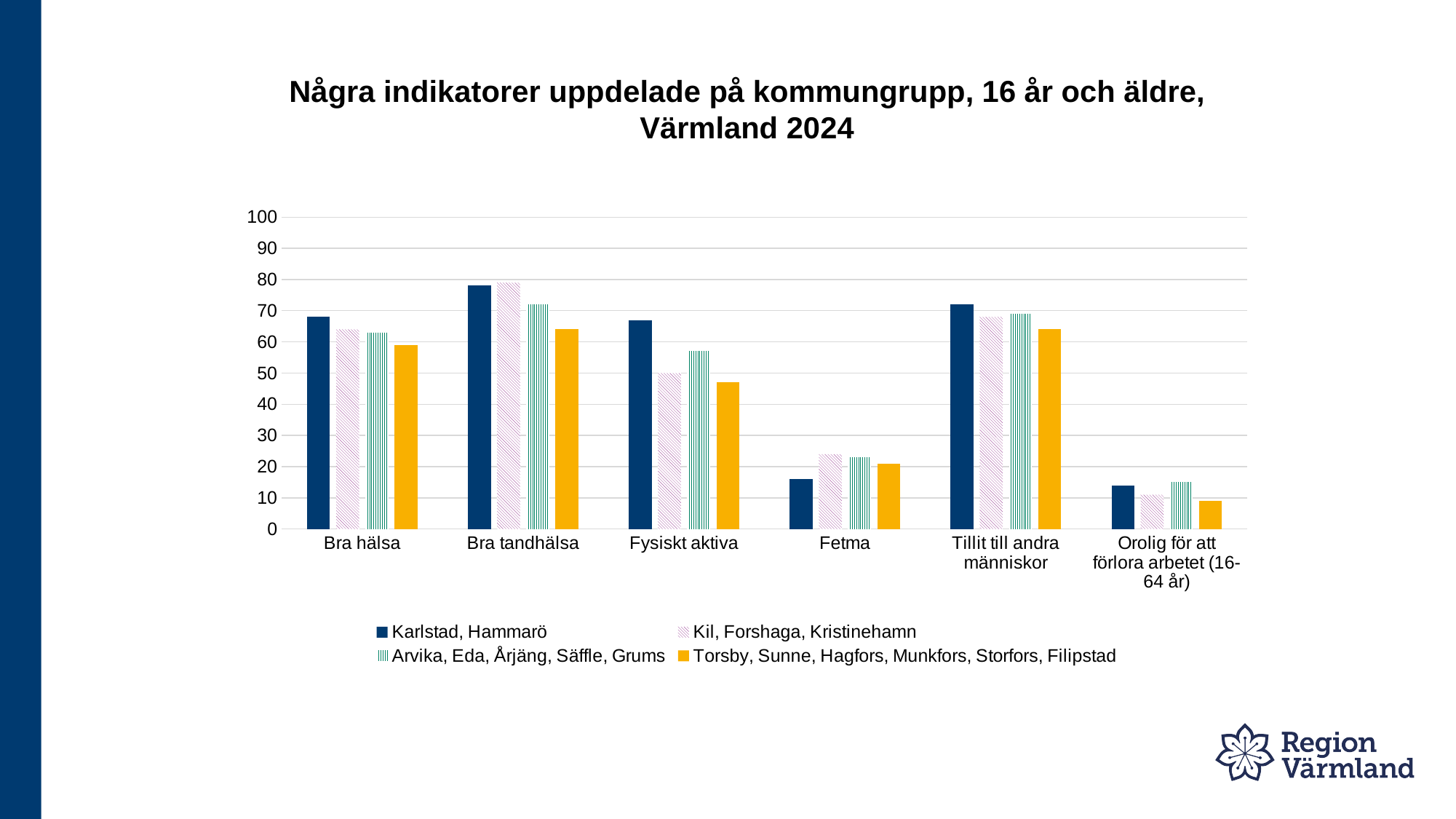
In the Fysiskt aktiva category, which is larger: Karlstad, Hammarö or Kil, Forshaga, Kristinehamn? Karlstad, Hammarö For the Torsby, Sunne, Hagfors, Munkfors, Storfors, Filipstad series, which category has the lowest value? Orolig för att förlora arbetet (16-64 år) Is the value for Torsby, Sunne, Hagfors, Munkfors, Storfors, Filipstad in the Bra tandhälsa category greater or less than 60? greater For the Karlstad, Hammarö series, which category has the highest value? Bra tandhälsa How many series does the legend list? 4 Is the value for Karlstad, Hammarö in the Bra hälsa category greater or less than 60? greater What kind of chart is shown on the slide? bar chart In the Fetma category, which series has the lowest value? Karlstad, Hammarö What is the title of the chart? Några indikatorer uppdelade på kommungrupp, 16 år och äldre, Värmland 2024 Is the value for Torsby, Sunne, Hagfors, Munkfors, Storfors, Filipstad in the Fysiskt aktiva category greater or less than 60? less In the Orolig för att förlora arbetet (16-64 år) category, which is larger: Arvika, Eda, Årjäng, Säffle, Grums or Torsby, Sunne, Hagfors, Munkfors, Storfors, Filipstad? Arvika, Eda, Årjäng, Säffle, Grums How many indicator categories are shown on the x axis? 6